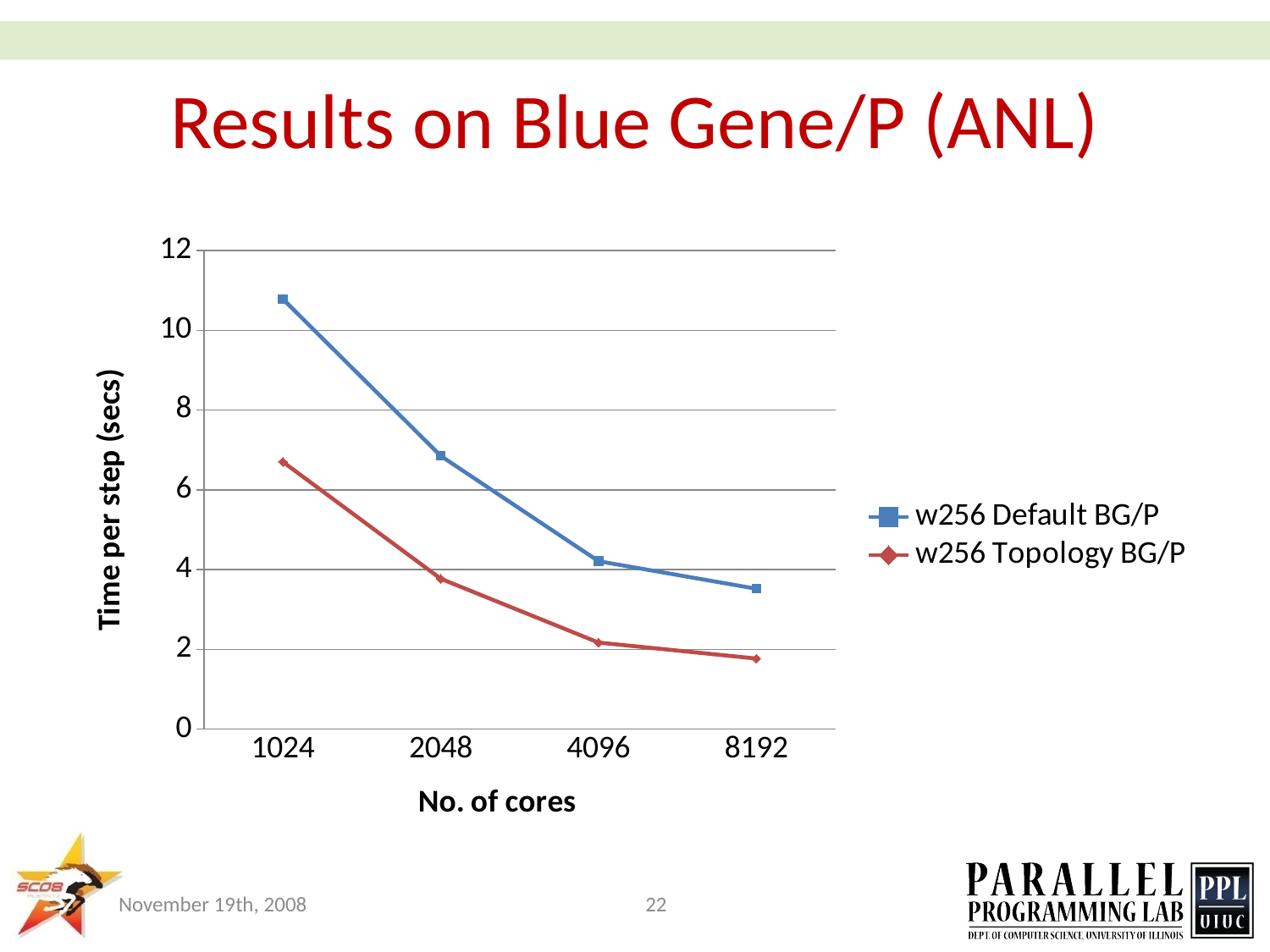
How many series does the legend list? 2 At which number of cores is the time per step for w256 Topology BG/P highest? 1024 Is the time per step for w256 Default BG/P at 8192 cores greater or less than 4? less What is the label of the y axis? Time per step (secs) What kind of chart is shown on the slide? line chart Is the time per step for w256 Topology BG/P at 1024 cores greater or less than 6? greater How many core counts are plotted along the x axis? 4 At which number of cores is the time per step for w256 Default BG/P lowest? 8192 Is the time per step for w256 Topology BG/P at 4096 cores greater or less than 4? less At 1024 cores, which series has the larger time per step, w256 Default BG/P or w256 Topology BG/P? w256 Default BG/P Does the time per step for w256 Default BG/P rise or fall as the number of cores increases? fall